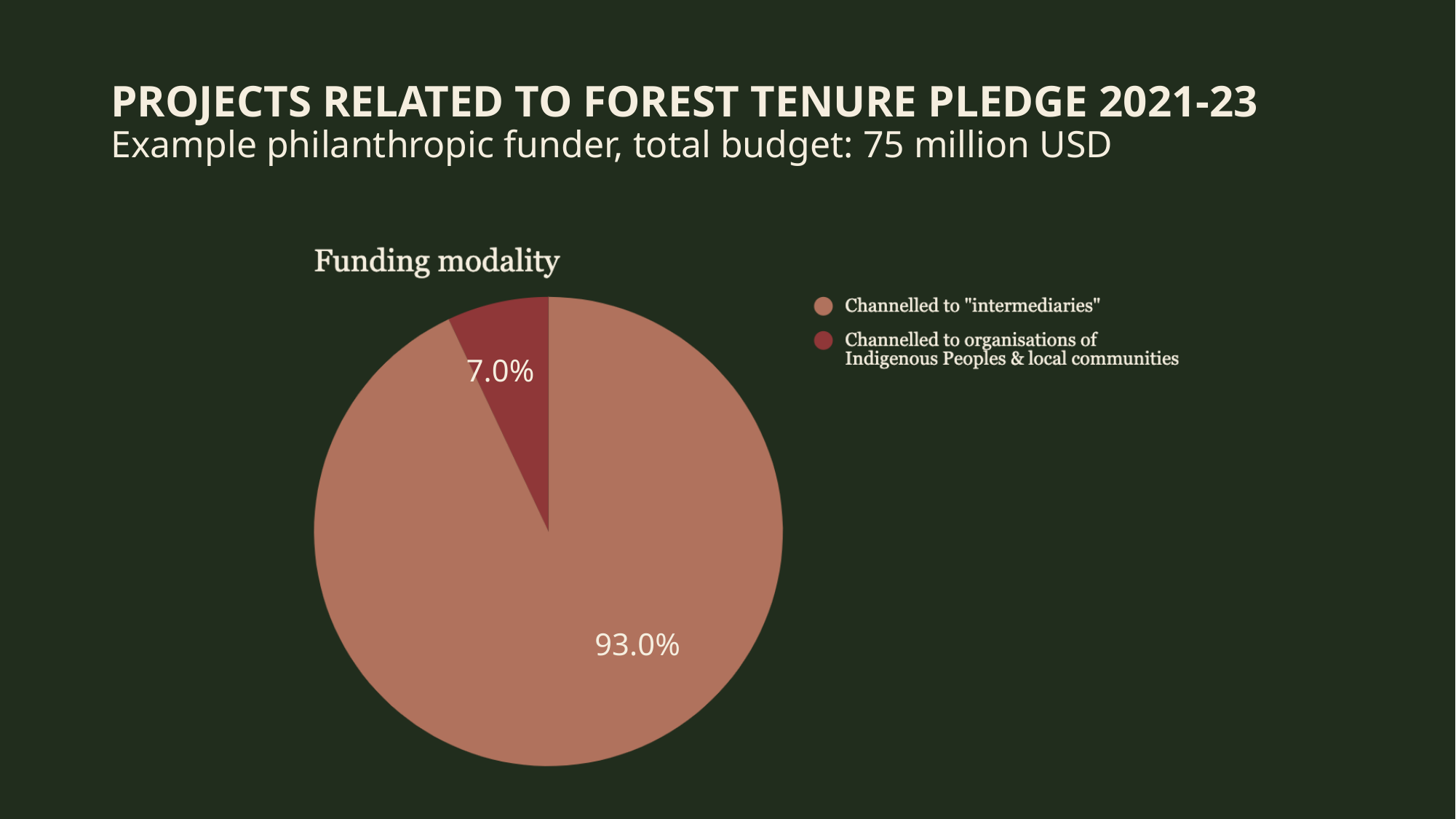
What colour is the slice for funding channelled to organisations of Indigenous Peoples & local communities? Dark red What is the title of the chart? Funding modality Which is larger: the share channelled to "intermediaries" or the share channelled to organisations of Indigenous Peoples & local communities? Channelled to "intermediaries" What share of funding is channelled to "intermediaries"? 93.0% How many slices does the pie chart have? 2 What is the total budget stated in the slide subtitle? 75 million USD What kind of chart is shown on the slide? Pie chart What is the difference in percentage points between the share channelled to "intermediaries" and the share channelled to organisations of Indigenous Peoples & local communities? 86.0 percentage points Which funding modality has the largest share of the pie? Channelled to "intermediaries" What share of funding is channelled to organisations of Indigenous Peoples & local communities? 7.0% Which funding modality has the smallest share of the pie? Channelled to organisations of Indigenous Peoples & local communities How many entries does the legend list? 2